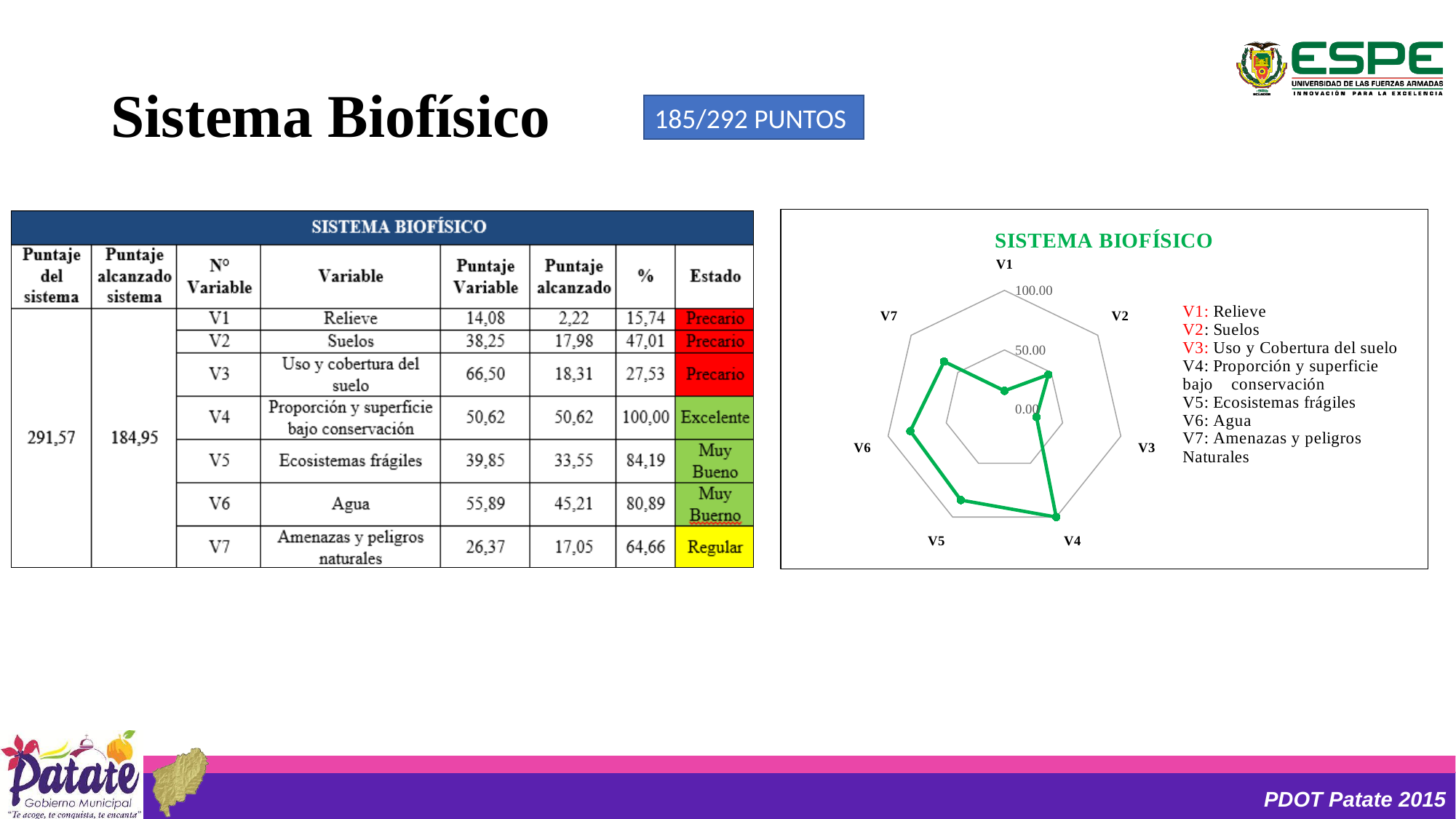
Which variable has the highest value on the radar chart? V4 How many variables (axes) does the radar chart have? 7 Is the value for V1 on the radar chart greater or less than 50.00? less What is the title of the chart on the slide? SISTEMA BIOFÍSICO Is the value for V5 on the radar chart greater or less than 50.00? greater On the radar chart, which is larger, the value for V2 or the value for V3? V2 What kind of chart is shown on the slide? Radar chart Is the value for V6 on the radar chart greater or less than 50.00? greater Which variable has the lowest value on the radar chart? V1 What is the highest axis tick value shown on the radar chart? 100.00